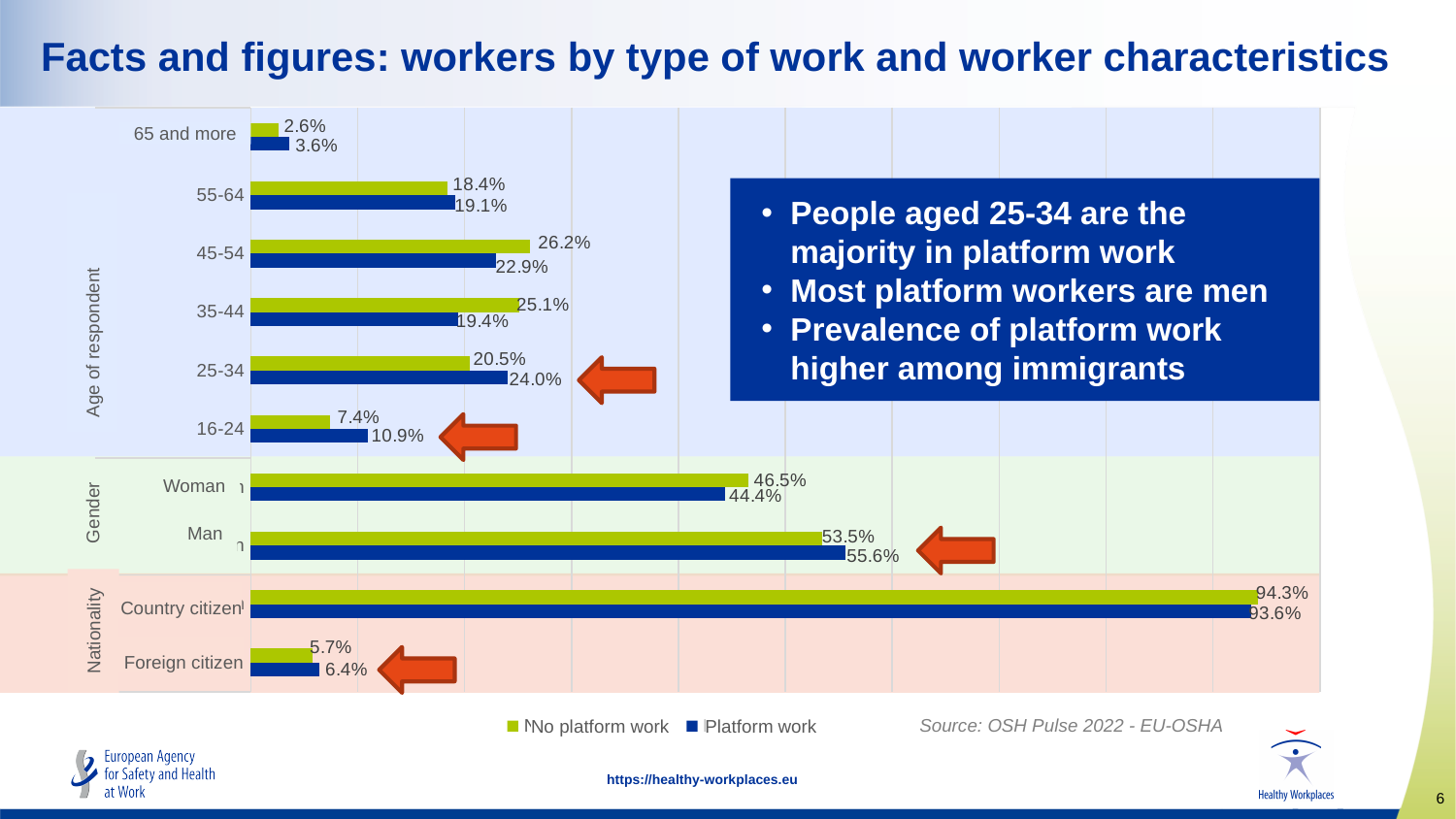
What is the Platform work value for the 25-34 age group? 24.0% What is the No platform work value for the 45-54 age group? 26.2% How many categories are plotted on the chart? 10 What is the Platform work value for Man? 55.6% How many series does the legend list? 2 Which age group has the lowest No platform work value? 65 and more What is the source cited for the chart? OSH Pulse 2022 - EU-OSHA Which is larger for Woman: the No platform work value or the Platform work value? No platform work What is the No platform work value for Foreign citizen? 5.7% Which age group has the highest Platform work value? 25-34 What kind of chart is shown on the slide? Bar chart What is the difference between the Platform work and No platform work values for the 16-24 age group? 3.5%